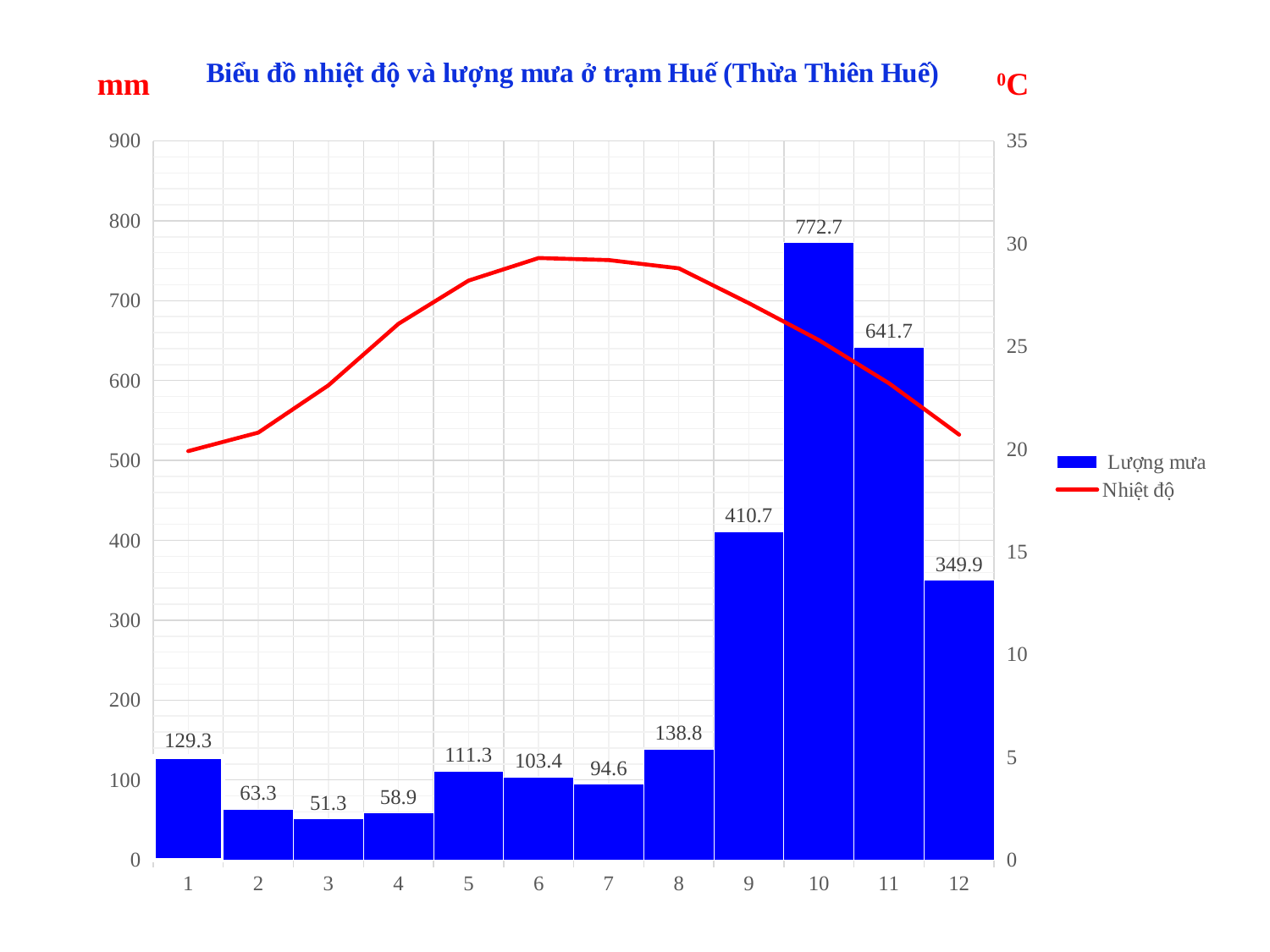
Is the temperature (Nhiệt độ) value for month 6 greater or less than 25? greater Which month has higher rainfall, month 5 or month 6? 5 What is the rainfall (Lượng mưa) value for month 10? 772.7 How many months are shown on the x axis? 12 How many series does the legend list? 2 Which month has the lowest rainfall (Lượng mưa)? 3 What is the difference in rainfall between month 10 and month 11? 131.0 What kind of chart is shown on the slide? Combination bar and line chart Which month has the highest rainfall (Lượng mưa)? 10 What is the rainfall (Lượng mưa) value for month 3? 51.3 Does the temperature (Nhiệt độ) line rise or fall from month 1 to month 6? rise Is the temperature (Nhiệt độ) value for month 1 greater or less than 25? less